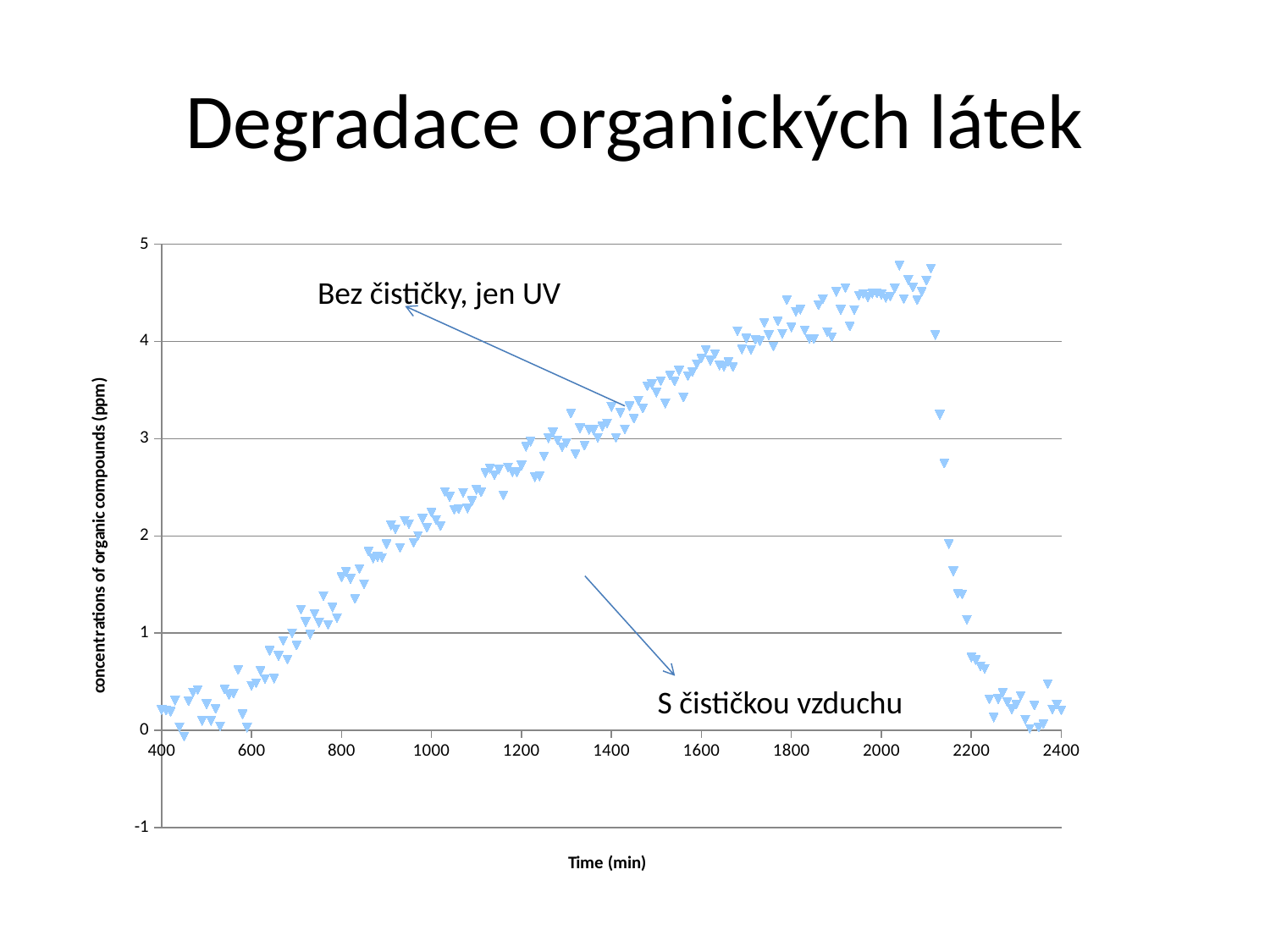
Which is larger, the concentration value at 1000 min or at 1800 min? 1800 min Is the concentration value at time 1600 min greater or less than 3? greater Do the plotted concentration values rise or fall between 2100 min and 2400 min? fall Do the plotted concentration values rise or fall between 400 min and 2000 min? rise Is the concentration value at time 2200 min greater or less than 2? less Is the concentration value at time 800 min greater or less than 2? less What is the label of the x axis of the chart? Time (min) What is the title of the slide containing the chart? Degradace organických látek What kind of chart is shown on the slide? scatter chart